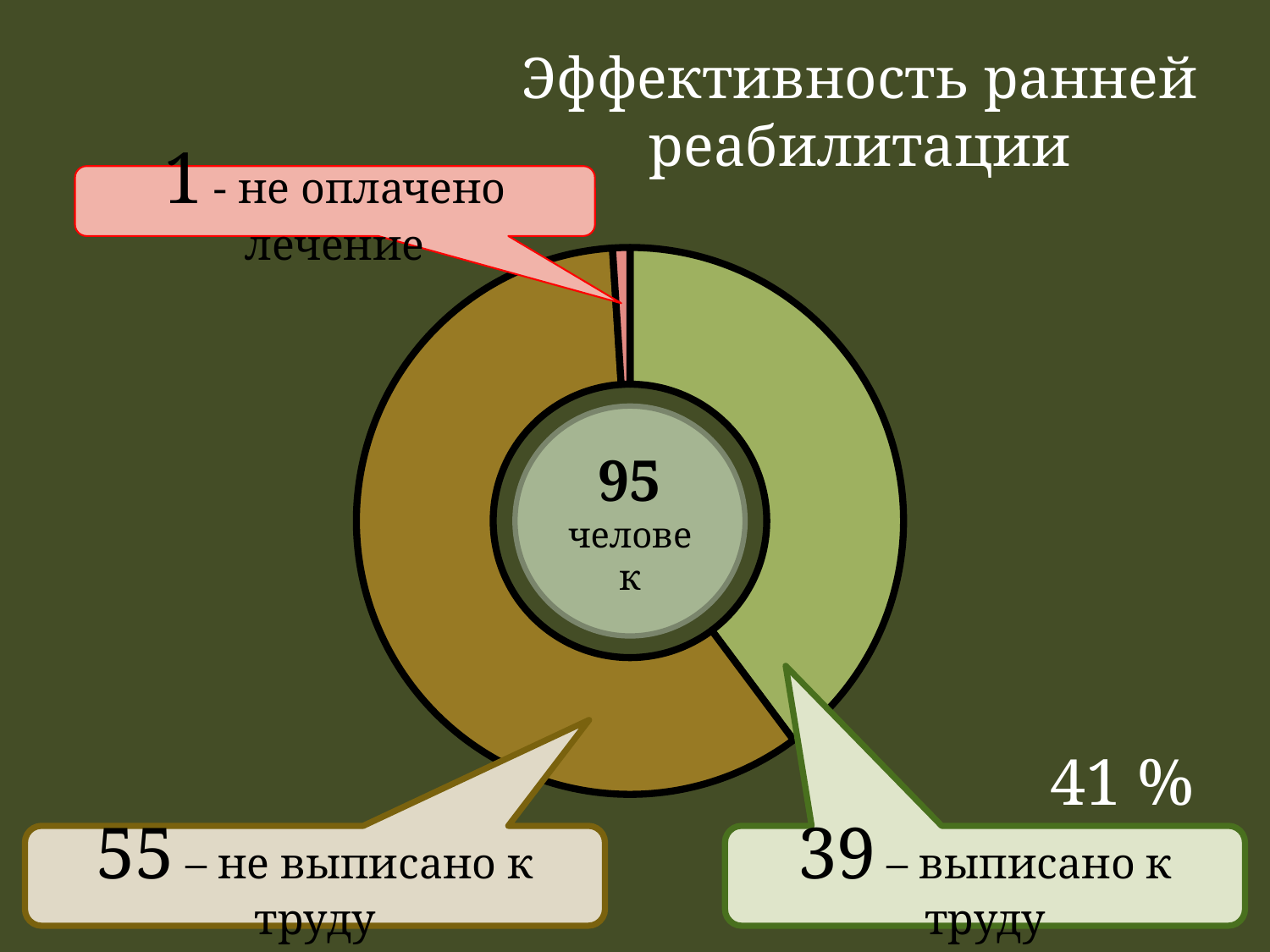
How many people does the chart cover in total, as shown in the centre of the donut? 95 человек Which is larger: the number 'выписано к труду' or the number 'не оплачено лечение'? выписано к труду What is the title of the chart on the slide? Эффективность ранней реабилитации What percentage share is shown for the 'выписано к труду' segment? 41 % How many people are labelled as 'не выписано к труду'? 55 What kind of chart is shown on the slide? Donut (pie) chart How many people are labelled as 'выписано к труду'? 39 How many people are labelled as 'не оплачено лечение'? 1 How many segments does the donut chart have? 3 Which category has the largest segment in the donut chart? не выписано к труду Which category has the smallest segment in the donut chart? не оплачено лечение What is the difference between the number 'не выписано к труду' and the number 'выписано к труду'? 16